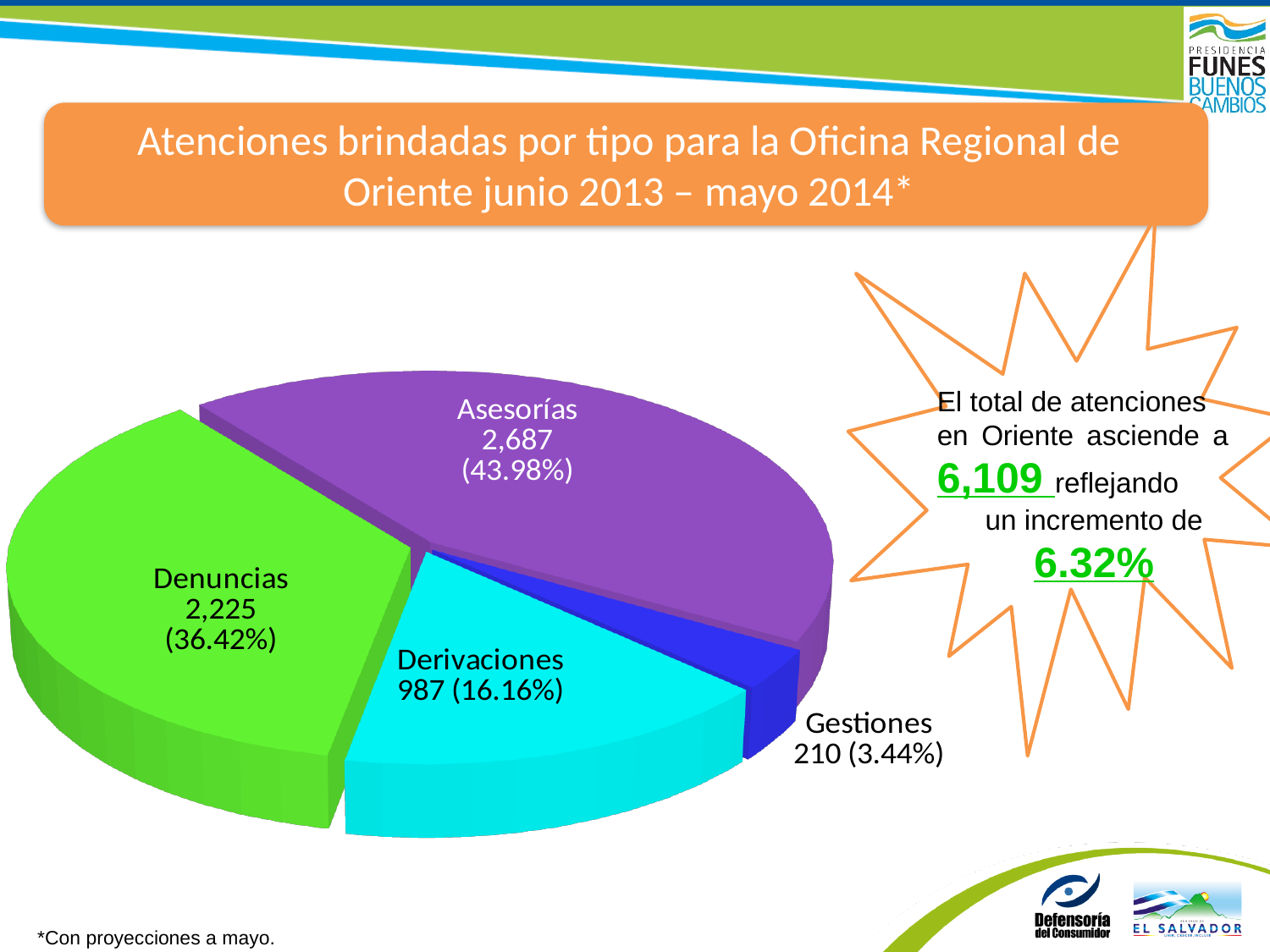
What colour is the Denuncias slice? green What percentage share does Derivaciones have? 16.16% How many slices does the pie chart have? 4 Which is larger, Derivaciones or Gestiones? Derivaciones Which category has the largest slice? Asesorías What is the difference between the values for Asesorías and Denuncias? 462 What kind of chart is shown on the slide? pie chart What is the value for Gestiones? 210 What is the value for Denuncias? 2,225 What percentage share does Asesorías have? 43.98% What is the value for Asesorías? 2,687 Which category has the smallest slice? Gestiones